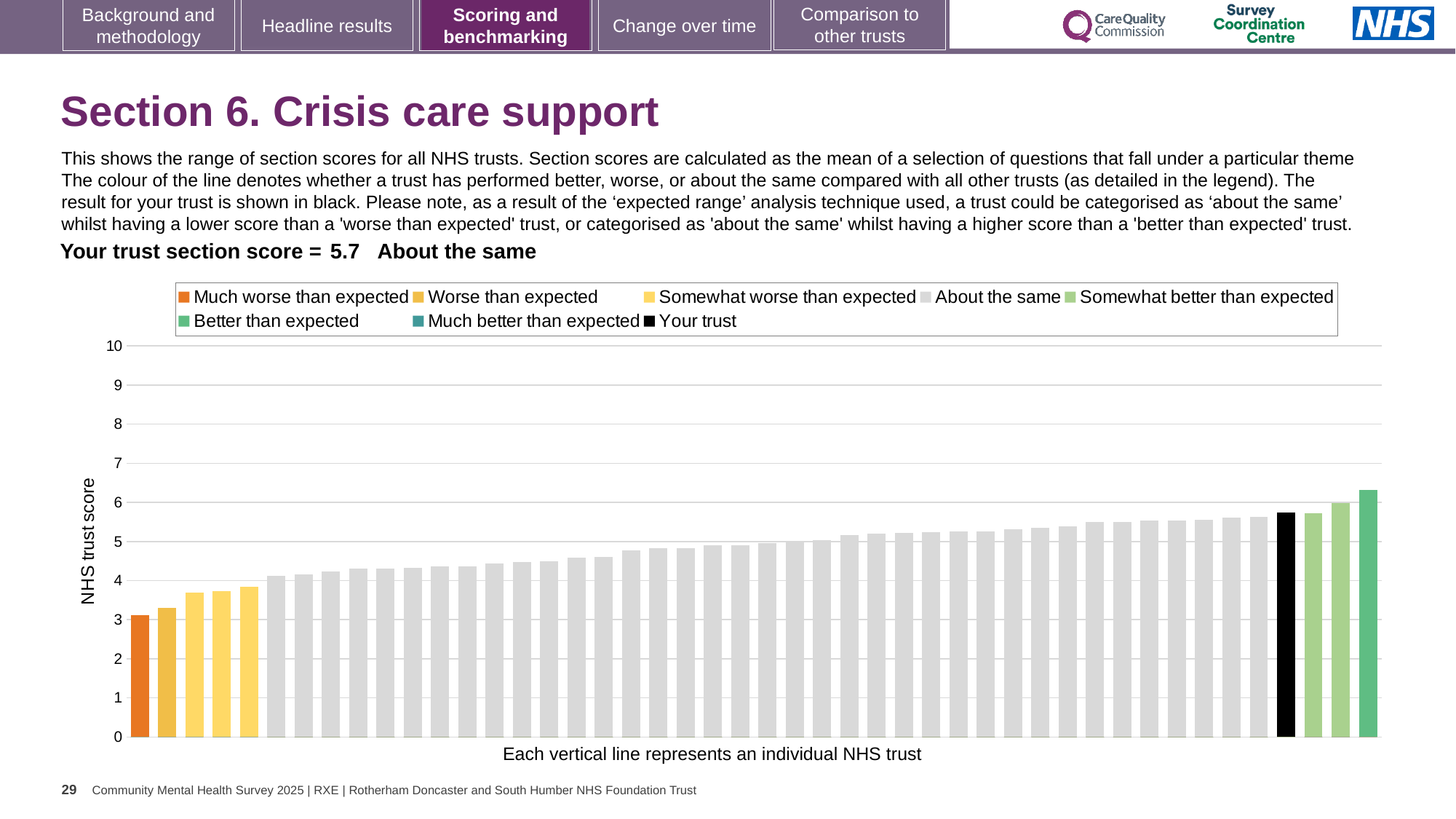
What is the section score for your trust? 5.7 What kind of chart is shown on the slide? Bar chart Is the value of the lowest bar (Much worse than expected) greater or less than 4? less Which category is your trust placed in for this section? About the same What is the label on the vertical axis of the chart? NHS trust score Which legend category does the highest bar belong to? Better than expected How many trusts are shown as 'Somewhat worse than expected'? 3 Is the value of the highest bar (Better than expected) greater or less than 6? greater Is the value for your trust greater or less than 5? greater Do the bar values rise or fall from left to right along the x axis? Rise How many entries does the chart legend list? 8 Which legend category does the lowest bar belong to? Much worse than expected